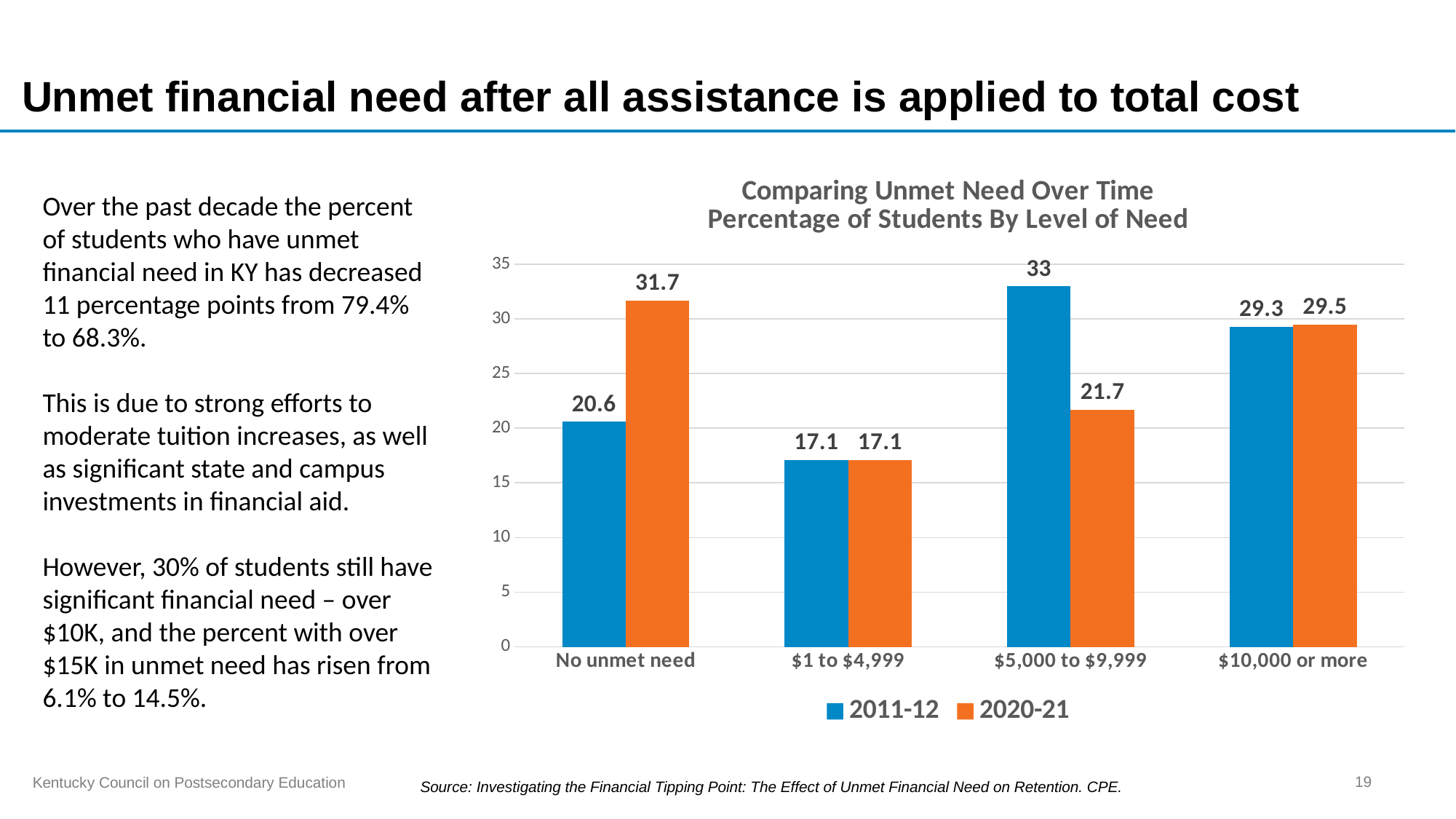
What is the value for 2011-12 in the "$5,000 to $9,999" category? 33 In the "No unmet need" category, which series has the larger value, 2011-12 or 2020-21? 2020-21 Which colour represents the 2020-21 series in the chart? Orange What is the difference between the 2020-21 and 2011-12 values in the "No unmet need" category? 11.1 What is the value for 2020-21 in the "$10,000 or more" category? 29.5 Which category has the highest value for the 2011-12 series? $5,000 to $9,999 How many series does the legend list? 2 What is the value for 2020-21 in the "No unmet need" category? 31.7 Which category has the lowest value for the 2020-21 series? $1 to $4,999 How many categories are shown on the x axis? 4 What kind of chart is shown on the slide? Bar chart What is the difference between the 2011-12 and 2020-21 values in the "$5,000 to $9,999" category? 11.3